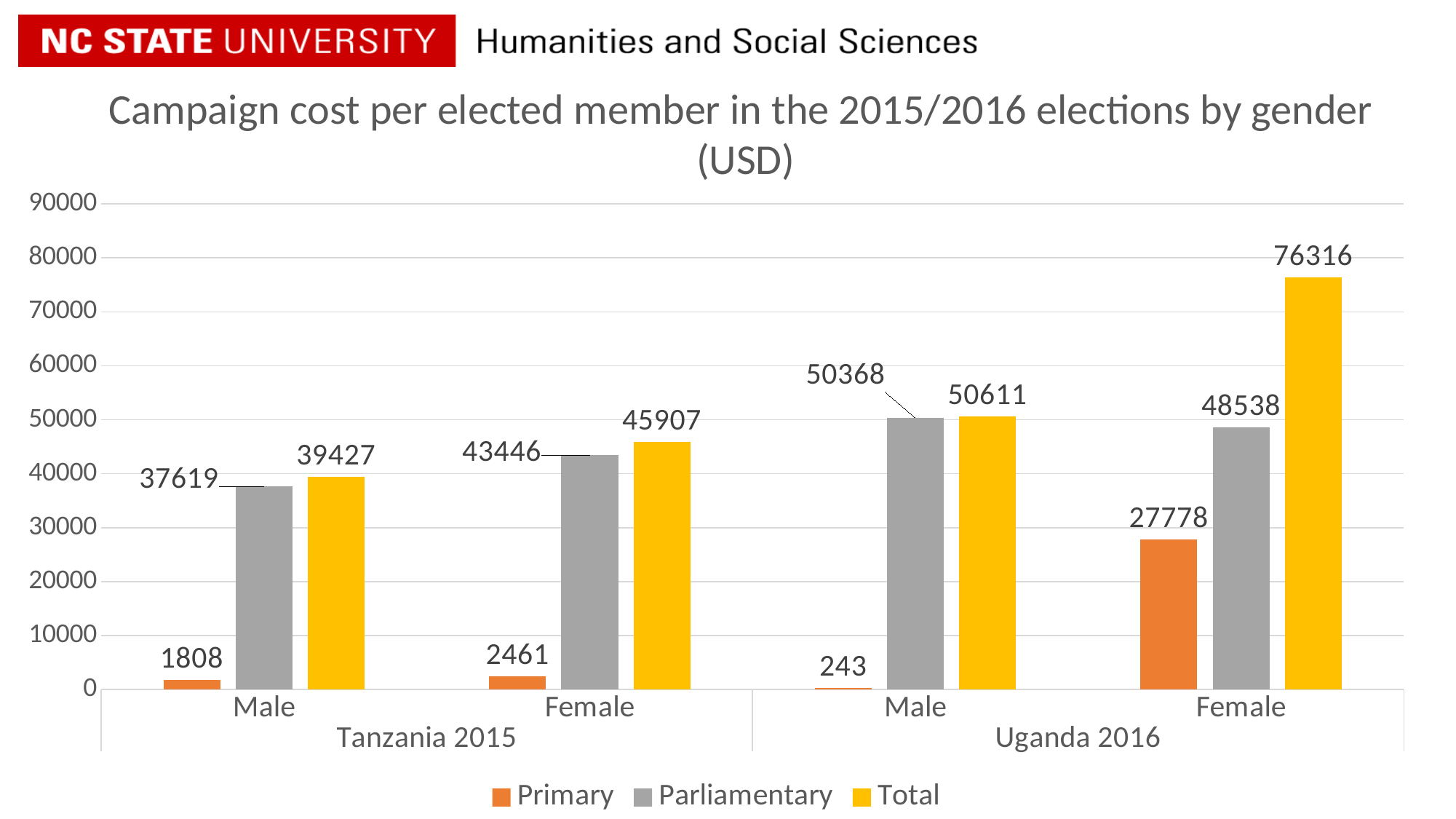
What is the difference between the Parliamentary campaign cost for Male and Female in Uganda 2016? 1830 What is the Total campaign cost per elected member for Female in Uganda 2016? 76316 What kind of chart is shown on the slide? Bar chart What is the Primary campaign cost per elected member for Female in Tanzania 2015? 2461 Which category has the highest Total campaign cost per elected member? Female, Uganda 2016 How many series does the legend list? 3 What is the Parliamentary campaign cost per elected member for Male in Tanzania 2015? 37619 Which category has the lowest Primary campaign cost per elected member? Male, Uganda 2016 What is the difference between the Total campaign cost for Female and Male in Tanzania 2015? 6480 What is the Primary campaign cost per elected member for Male in Uganda 2016? 243 Which is larger: the Primary campaign cost for Female in Uganda 2016 or for Female in Tanzania 2015? Female in Uganda 2016 Which colour represents the Parliamentary series in the chart? Grey